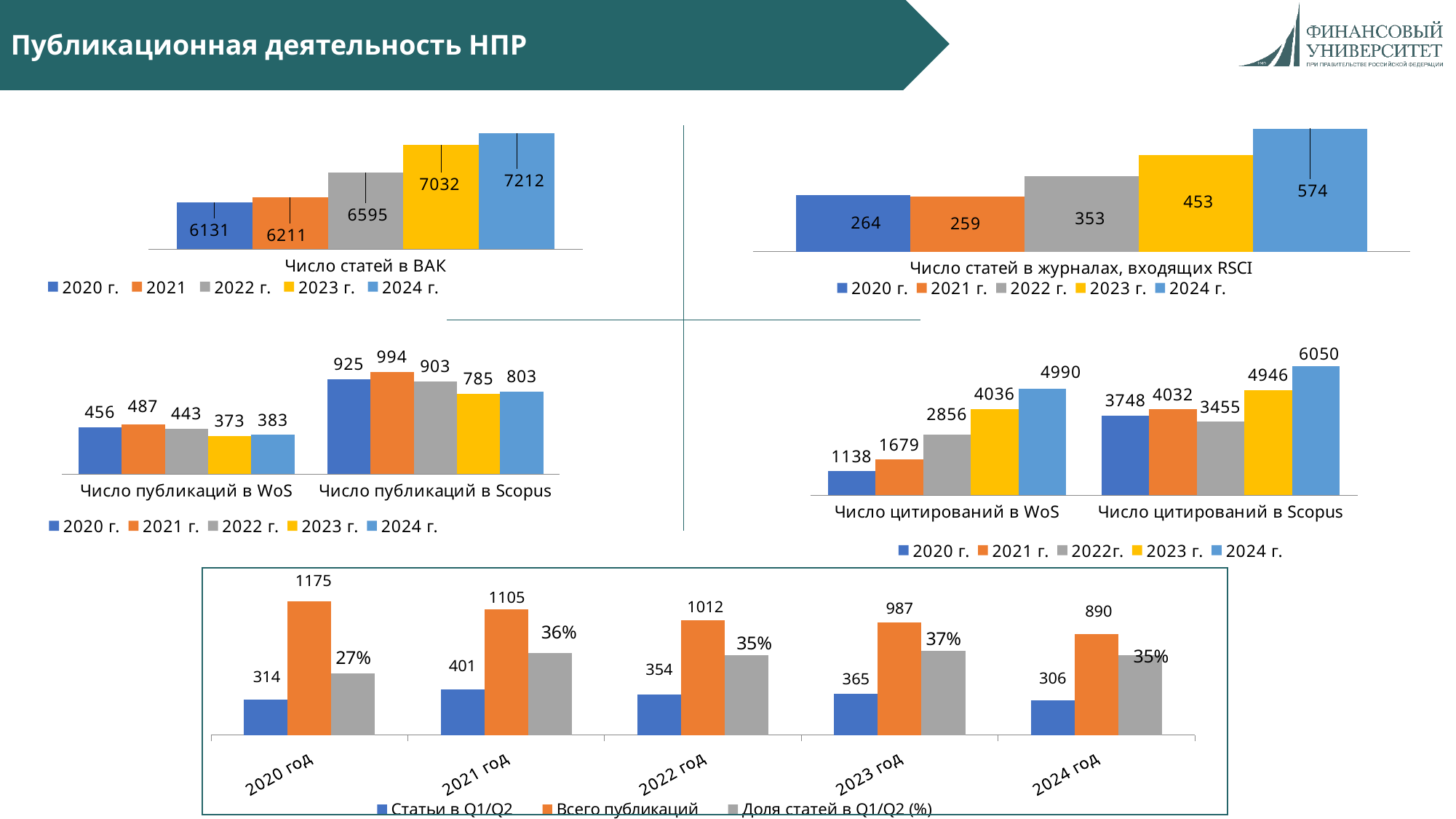
In the middle-left chart, which year has the lowest value in the Число публикаций в WoS group? 2023 г. In the bottom chart, what is the value of Всего публикаций for 2022 год? 1012 In the middle-right chart, what is the value for 2024 г. in the Число цитирований в Scopus group? 6050 In the top-left chart (Число статей в ВАК), what is the difference between the 2024 г. and 2020 г. values? 1081 In the bottom chart, what is the value of Доля статей в Q1/Q2 (%) for 2023 год? 37% In the top-left chart (Число статей в ВАК), what is the value for 2024 г.? 7212 In the top-right chart (Число статей в журналах, входящих RSCI), what is the value for 2023 г.? 453 How many series does the legend of the bottom chart list? 3 In the middle-left chart, what is the value for 2021 г. in the Число публикаций в Scopus group? 994 In the middle-right chart, which is larger: Число цитирований в WoS for 2022 г. or Число цитирований в Scopus for 2022 г.? Число цитирований в Scopus for 2022 г. In the middle-right chart, do the values for Число цитирований в WoS rise or fall from 2020 г. to 2024 г.? rise In the top-right chart (Число статей в журналах, входящих RSCI), which year has the lowest value? 2021 г.